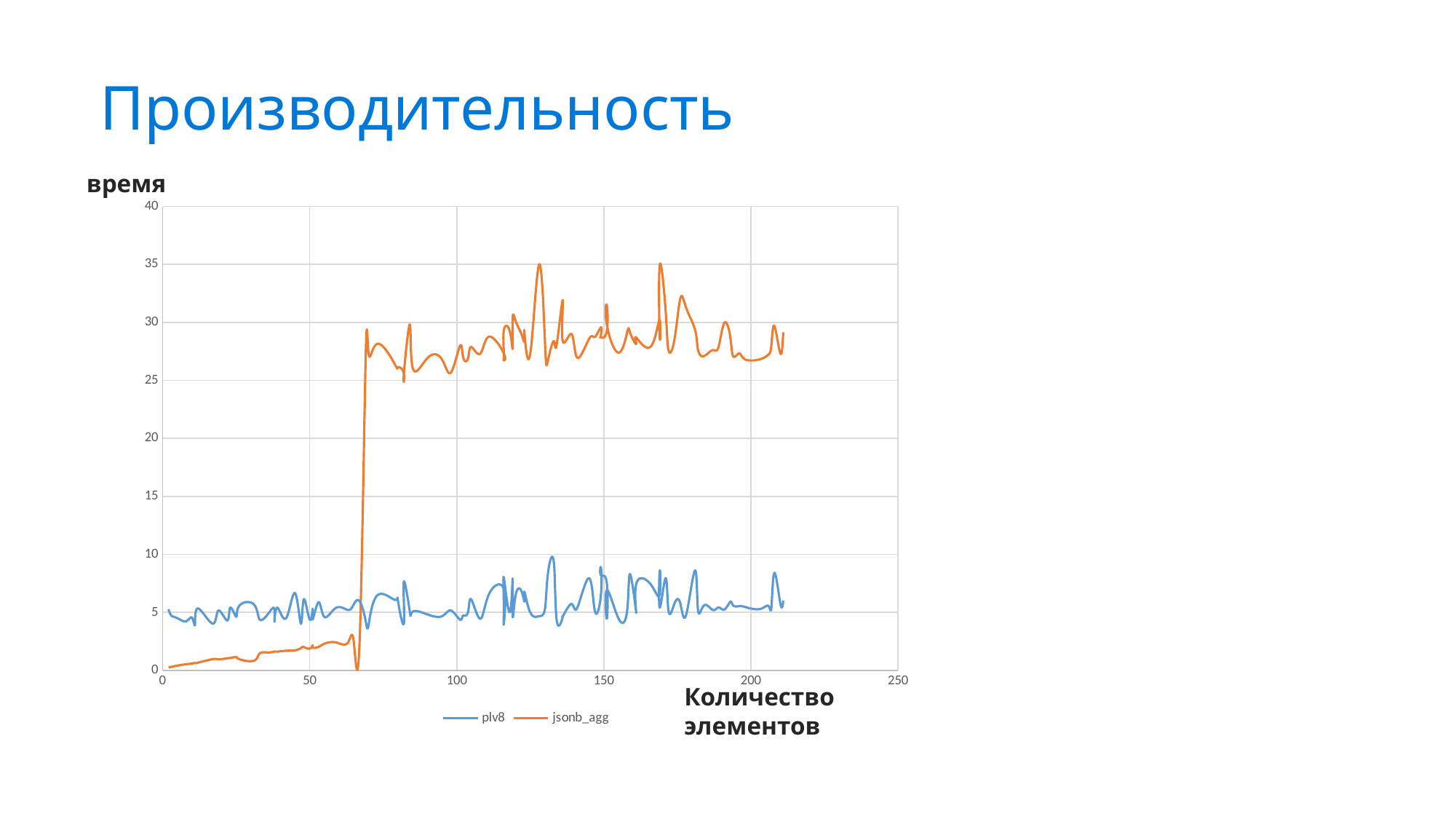
Is the value for jsonb_agg at 150 elements greater or less than 20? greater Is the value for plv8 at 150 elements greater or less than 15? less Which series reaches the highest value on the chart? jsonb_agg How many series does the legend list? 2 What kind of chart is shown on the slide? line chart Is the value for plv8 at 50 elements greater or less than 10? less What is the title of the slide above the chart? Производительность At 100 elements, which series has the larger value, plv8 or jsonb_agg? jsonb_agg What are the names of the two series in the legend? plv8 and jsonb_agg At 20 elements, which series has the larger value, plv8 or jsonb_agg? plv8 Does the jsonb_agg series rise or fall between 0 and 70 elements? rise